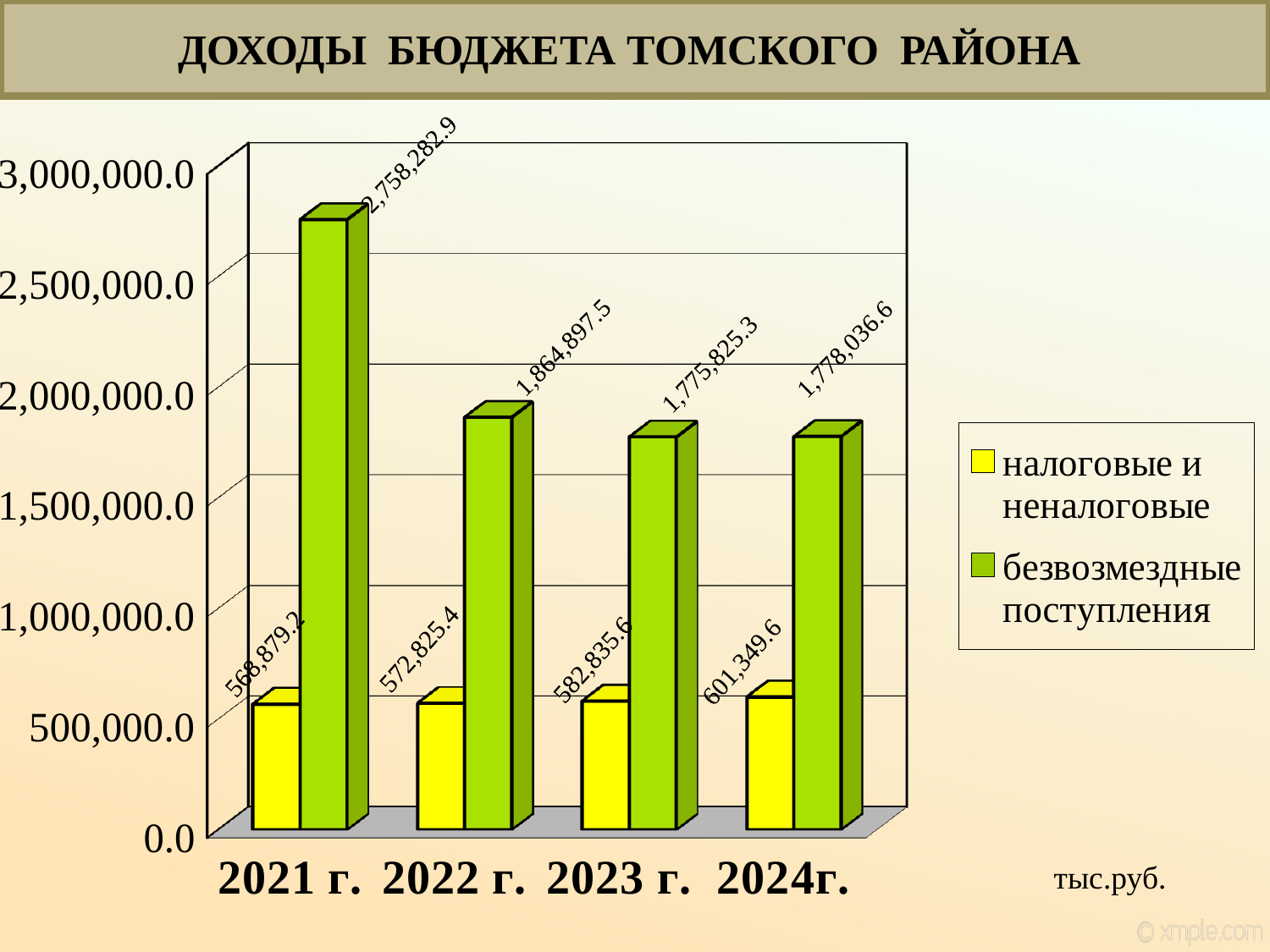
What is the value of налоговые и неналоговые for 2024г.? 601,349.6 How many series does the legend list? 2 Is the value of безвозмездные поступления for 2021 г. greater or less than 2,500,000.0? greater What type of chart is shown on the slide? bar chart What is the difference between безвозмездные поступления in 2021 г. and 2022 г.? 893,385.4 Do the values of налоговые и неналоговые rise or fall from 2021 г. to 2024г.? rise How many years are shown on the x axis? 4 What is the value of безвозмездные поступления for 2023 г.? 1,775,825.3 In which year is безвозмездные поступления highest? 2021 г. What is the value of безвозмездные поступления for 2021 г.? 2,758,282.9 Which is larger: налоговые и неналоговые in 2022 г. or in 2024г.? 2024г. In which year is налоговые и неналоговые lowest? 2021 г.